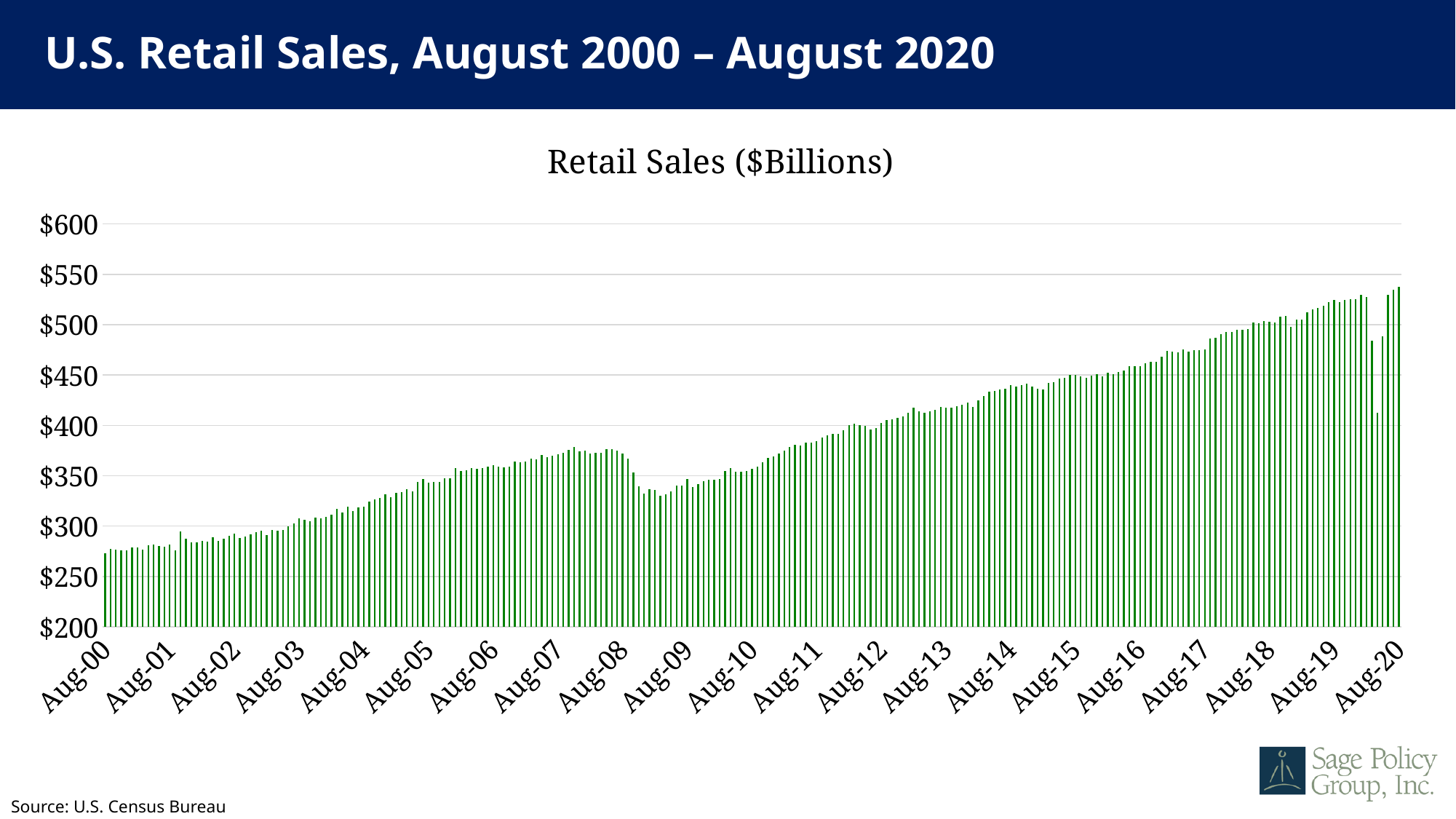
Is the value for Aug-17 greater or less than $450? greater What is the title of the chart? Retail Sales ($Billions) Is the value for Aug-00 greater or less than $300? less Is the value for Aug-04 greater or less than $300? greater Overall, do retail sales rise or fall from Aug-00 to Aug-20? rise How many year labels are shown on the x axis? 21 Which labelled month has the lowest retail sales value? Aug-00 Which is larger, the value for Aug-08 or the value for Aug-09? Aug-08 What source is cited for the chart data? U.S. Census Bureau What kind of chart is shown on the slide? bar chart